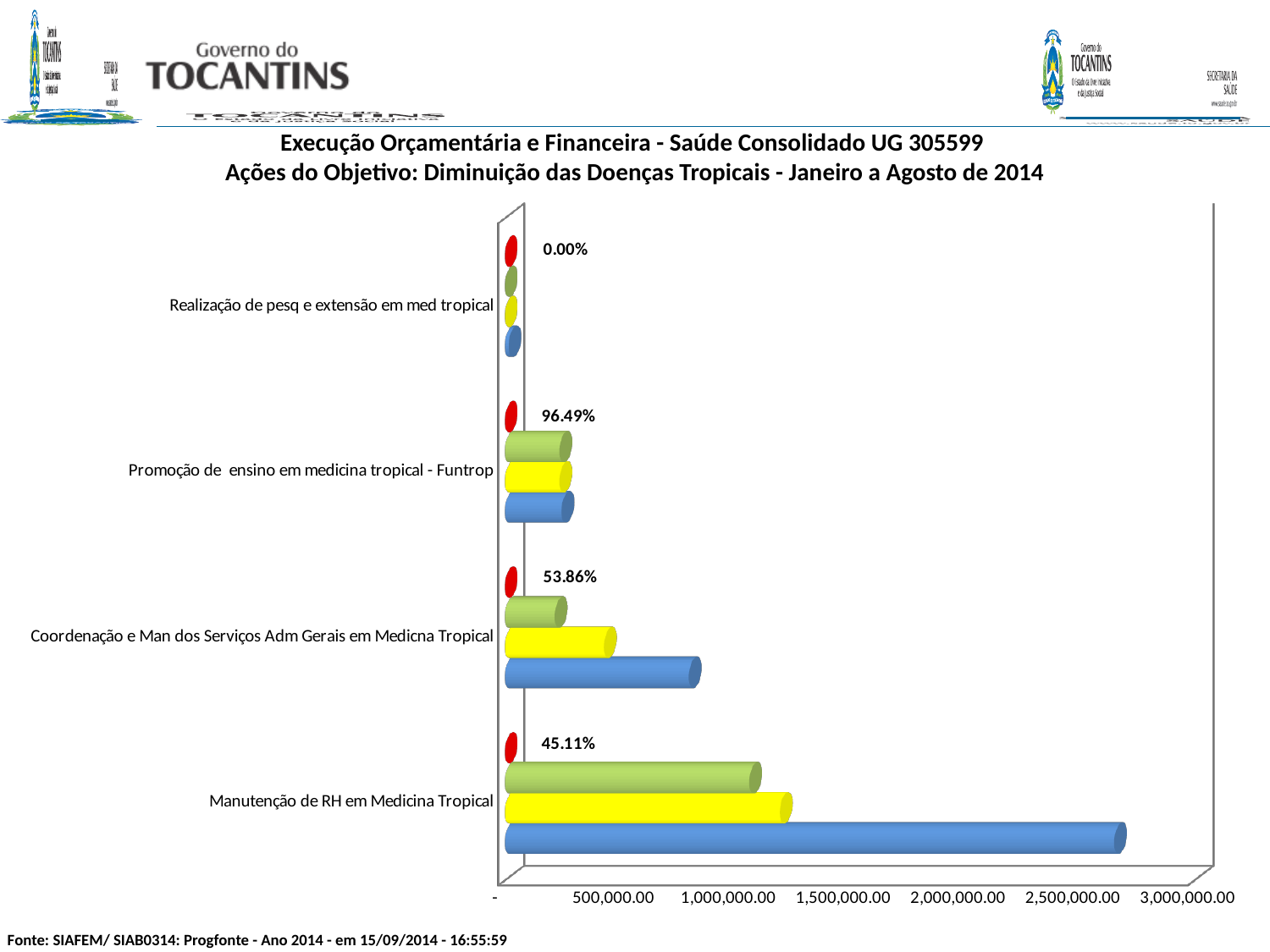
What percentage is shown for Promoção de ensino em medicina tropical - Funtrop? 96.49% What percentage is shown for Realização de pesq e extensão em med tropical? 0.00% How many categories are shown on the chart? 4 Which category has the highest percentage label? Promoção de ensino em medicina tropical - Funtrop Is the value of the blue bar for Coordenação e Man dos Serviços Adm Gerais em Medicna Tropical greater or less than 1,000,000.00? less What percentage is shown for Manutenção de RH em Medicina Tropical? 45.11% Is the value of the blue bar for Manutenção de RH em Medicina Tropical greater or less than 2,500,000.00? greater What kind of chart is shown on the slide? Bar chart What percentage is shown for Coordenação e Man dos Serviços Adm Gerais em Medicna Tropical? 53.86% Which has the larger percentage label: Coordenação e Man dos Serviços Adm Gerais em Medicna Tropical or Manutenção de RH em Medicina Tropical? Coordenação e Man dos Serviços Adm Gerais em Medicna Tropical What is the difference between the percentage labels for Promoção de ensino em medicina tropical - Funtrop and Coordenação e Man dos Serviços Adm Gerais em Medicna Tropical? 42.63% Which category has the lowest percentage label? Realização de pesq e extensão em med tropical